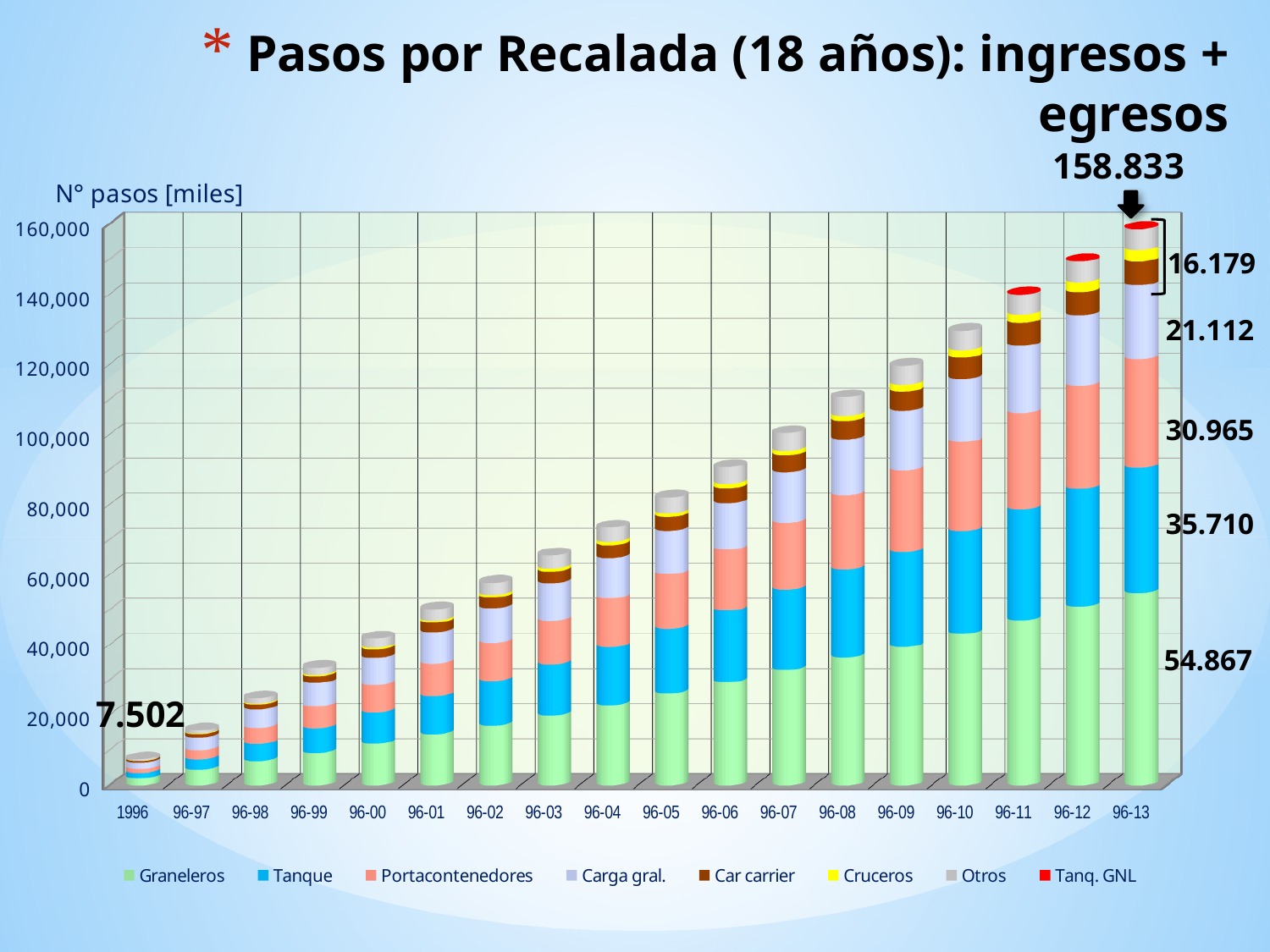
How many series does the legend list? 8 What is the value of the Carga gral. segment in the 96-13 bar? 21.112 In the 96-13 bar, which is larger: the Graneleros segment or the Portacontenedores segment? Graneleros How many periods (categories) are plotted along the x axis? 18 What is the value of the Graneleros segment in the 96-13 bar? 54.867 What is the total value labelled for the 96-13 bar? 158.833 Do the bar totals rise or fall from 1996 to 96-13? Rise What kind of chart is shown on the slide? Stacked bar chart What is the total value labelled for the 1996 bar? 7.502 What is the value of the Tanque segment in the 96-13 bar? 35.710 Which period has the highest total? 96-13 Is the total for 96-06 greater or less than 100,000? less